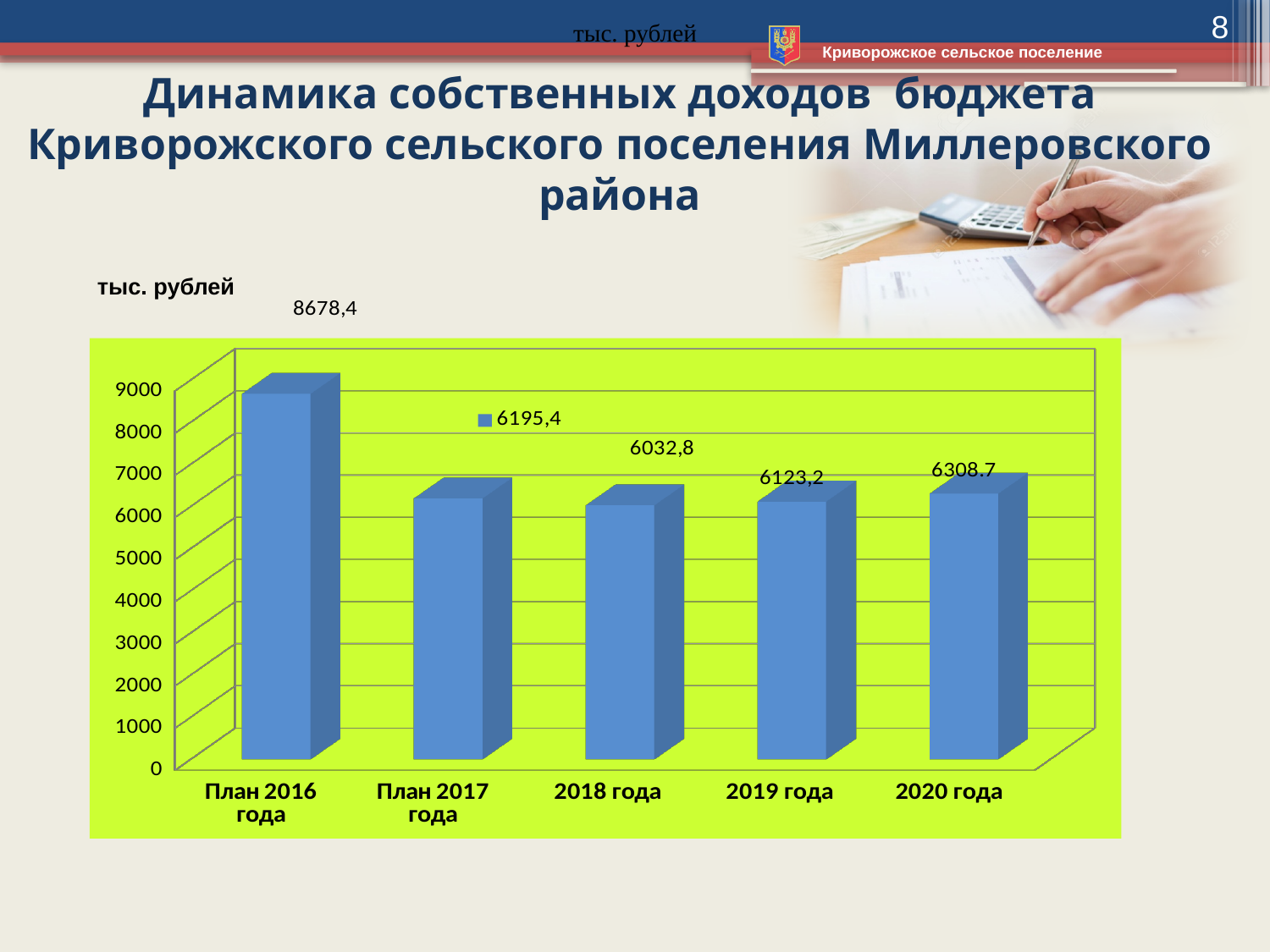
What kind of chart is shown on the slide? bar chart What is the difference between the values for План 2017 года and 2018 года? 162,6 What is the value for План 2017 года? 6195,4 What is the value for План 2016 года? 8678,4 Which category has the lowest value? 2018 года Which is larger, the value for 2019 года or the value for 2018 года? 2019 года Do the values rise or fall from 2018 года to 2020 года? rise What is the value for 2020 года? 6308.7 How many categories are shown on the x axis? 5 Which category has the highest value? План 2016 года What is the value for 2018 года? 6032,8 Is the value for 2020 года greater or less than 6000? greater